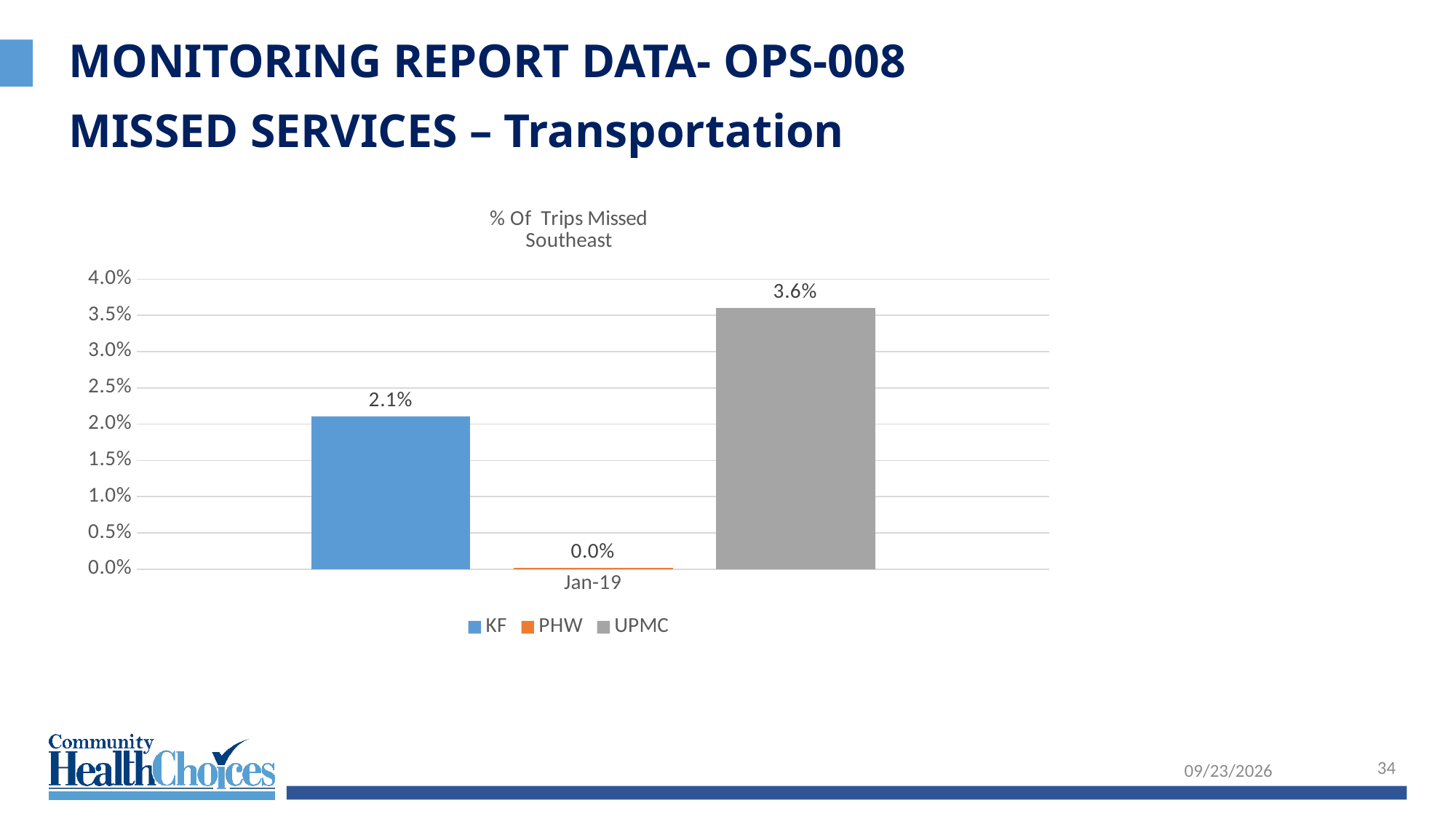
Which series has the lowest % of trips missed? PHW What is the value for PHW in Jan-19? 0.0% What is the title of the chart? % Of Trips Missed Southeast How many series does the legend list? 3 What is the difference between the UPMC and KF values? 1.5% Is the value for UPMC greater or less than 3.0%? greater Which series has the highest % of trips missed? UPMC How many categories are shown on the x axis? 1 What kind of chart is shown on the slide? bar chart Which is larger, the value for KF or the value for UPMC? UPMC What is the value for KF in Jan-19? 2.1% What is the value for UPMC in Jan-19? 3.6%